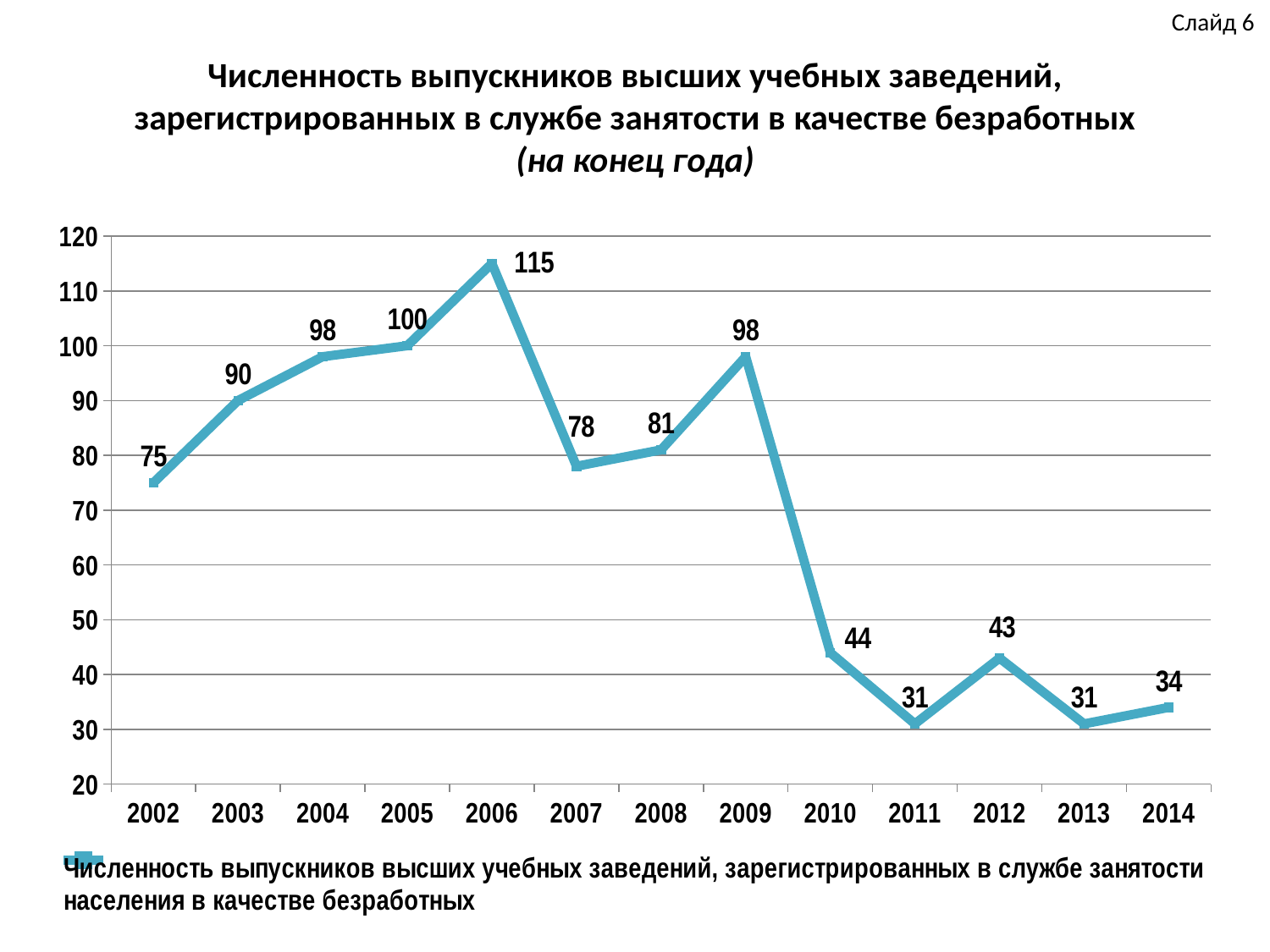
How many series does the legend list? 1 Which is larger, the value for 2005 or the value for 2009? 2005 Which year has the highest value? 2006 What is the value for 2010? 44 How many years are plotted on the x axis? 13 What is the difference between the values for 2006 and 2007? 37 What is the value for 2006? 115 What is the difference between the values for 2009 and 2010? 54 Do the values rise or fall from 2002 to 2006? rise What is the value for 2002? 75 What is the lowest value shown on the chart? 31 What kind of chart is shown on the slide? line chart